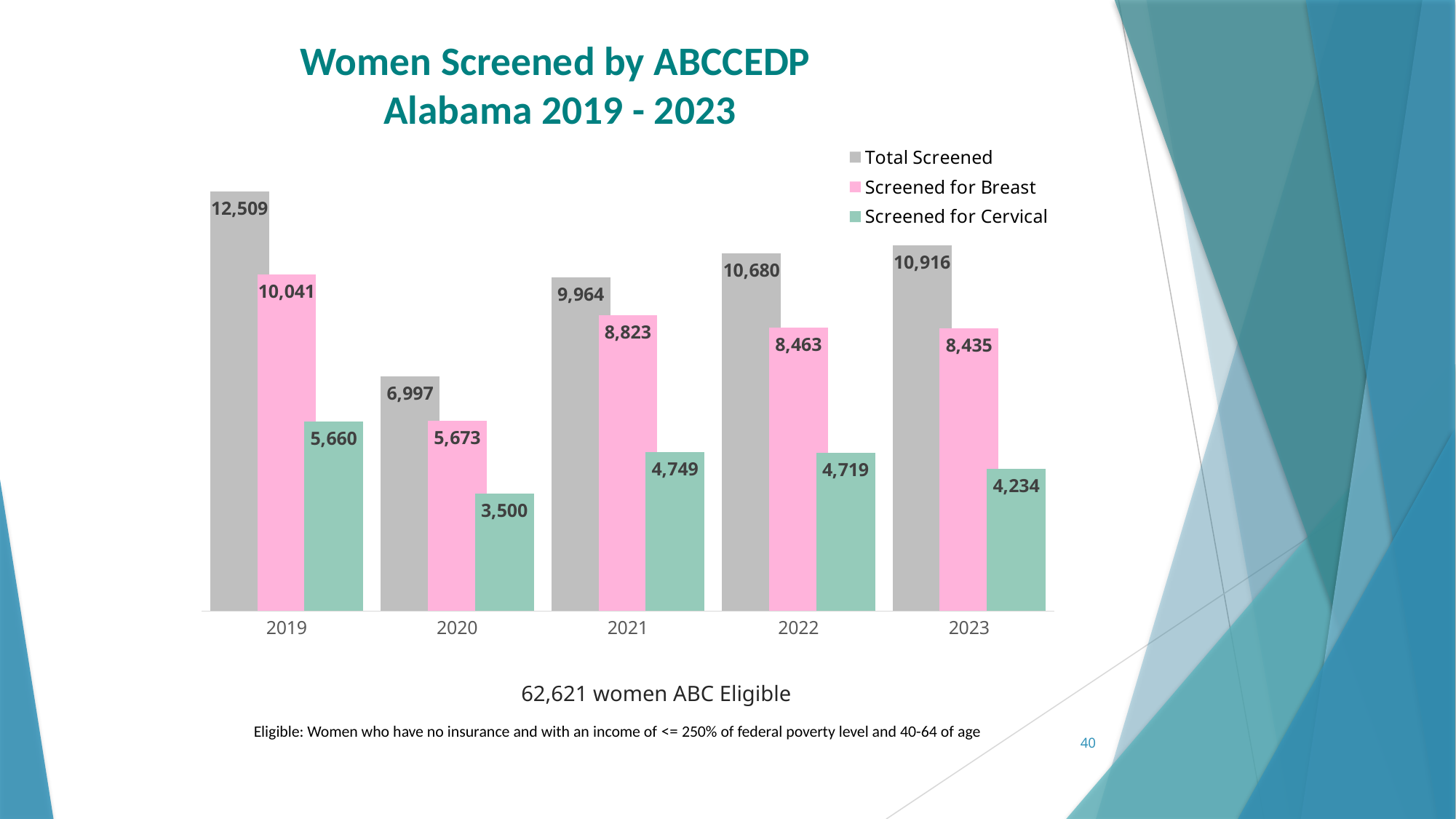
How many years are shown on the x axis? 5 What is the difference between Screened for Breast and Screened for Cervical in 2021? 4,074 What was the Total Screened value in 2019? 12,509 How many series does the legend list? 3 What is the title of the chart? Women Screened by ABCCEDP Alabama 2019 - 2023 What was the Screened for Breast value in 2023? 8,435 Which is larger: Screened for Cervical in 2019 or Screened for Cervical in 2023? Screened for Cervical in 2019 Which year had the lowest Screened for Breast value? 2020 How many women were Screened for Cervical in 2020? 3,500 What kind of chart is shown on the slide? Bar chart Which year had the highest Total Screened value? 2019 What is the difference between Total Screened in 2019 and Total Screened in 2020? 5,512